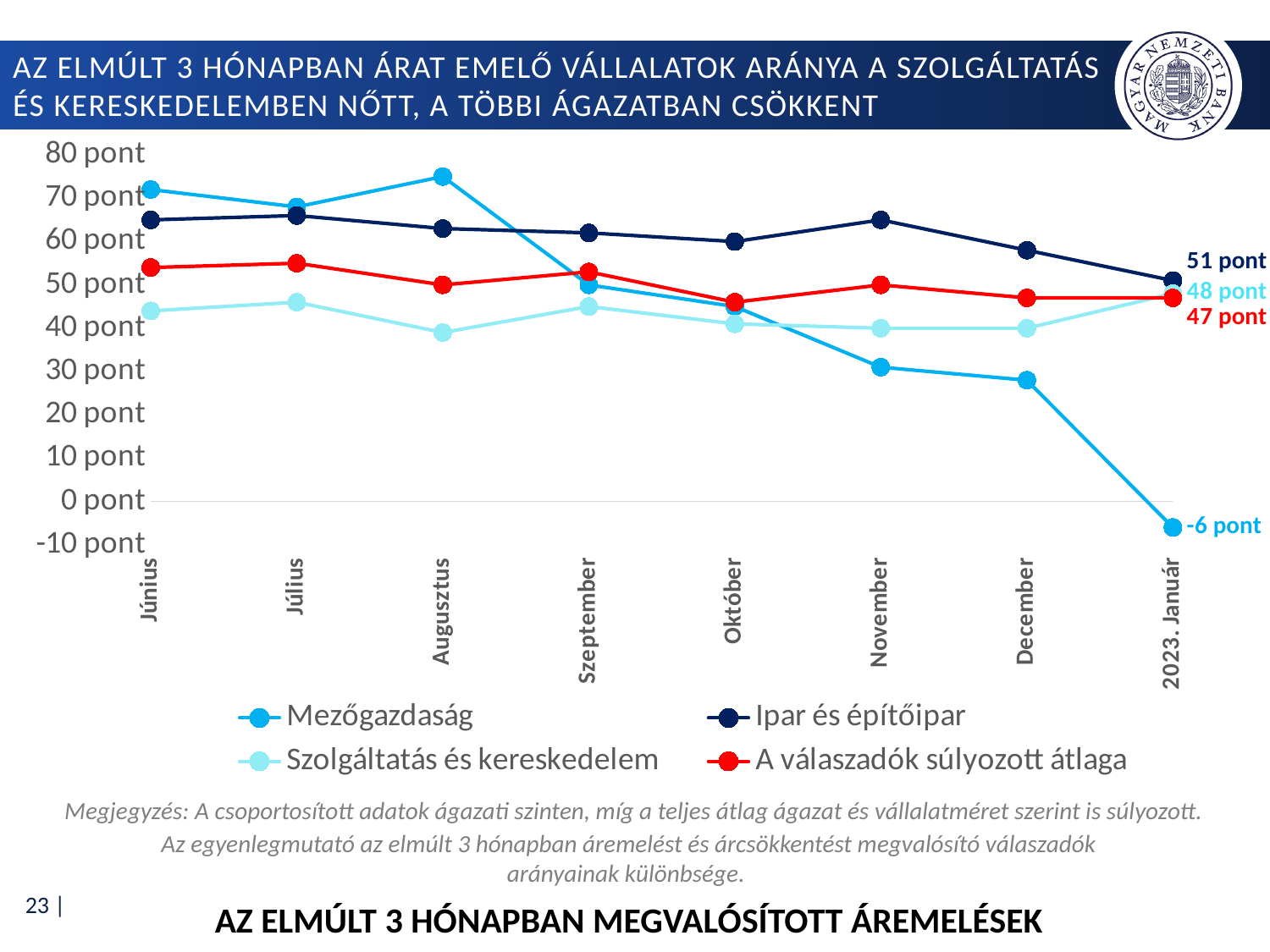
How many series does the legend list? 4 What is the difference between Ipar és építőipar and Mezőgazdaság in 2023. Január? 57 pont Which series has the lowest value in 2023. Január? Mezőgazdaság What is the value for A válaszadók súlyozott átlaga in 2023. Január? 47 pont Is the value for Mezőgazdaság in November greater or less than 40 pont? less Is the value for Mezőgazdaság in Augusztus greater or less than 70 pont? greater What kind of chart is shown on the slide? line chart How many months are shown on the x axis? 8 What is the value for Szolgáltatás és kereskedelem in 2023. Január? 48 pont What is the value for Ipar és építőipar in 2023. Január? 51 pont What is the value for Mezőgazdaság in 2023. Január? -6 pont Which series has the highest value in Június? Mezőgazdaság